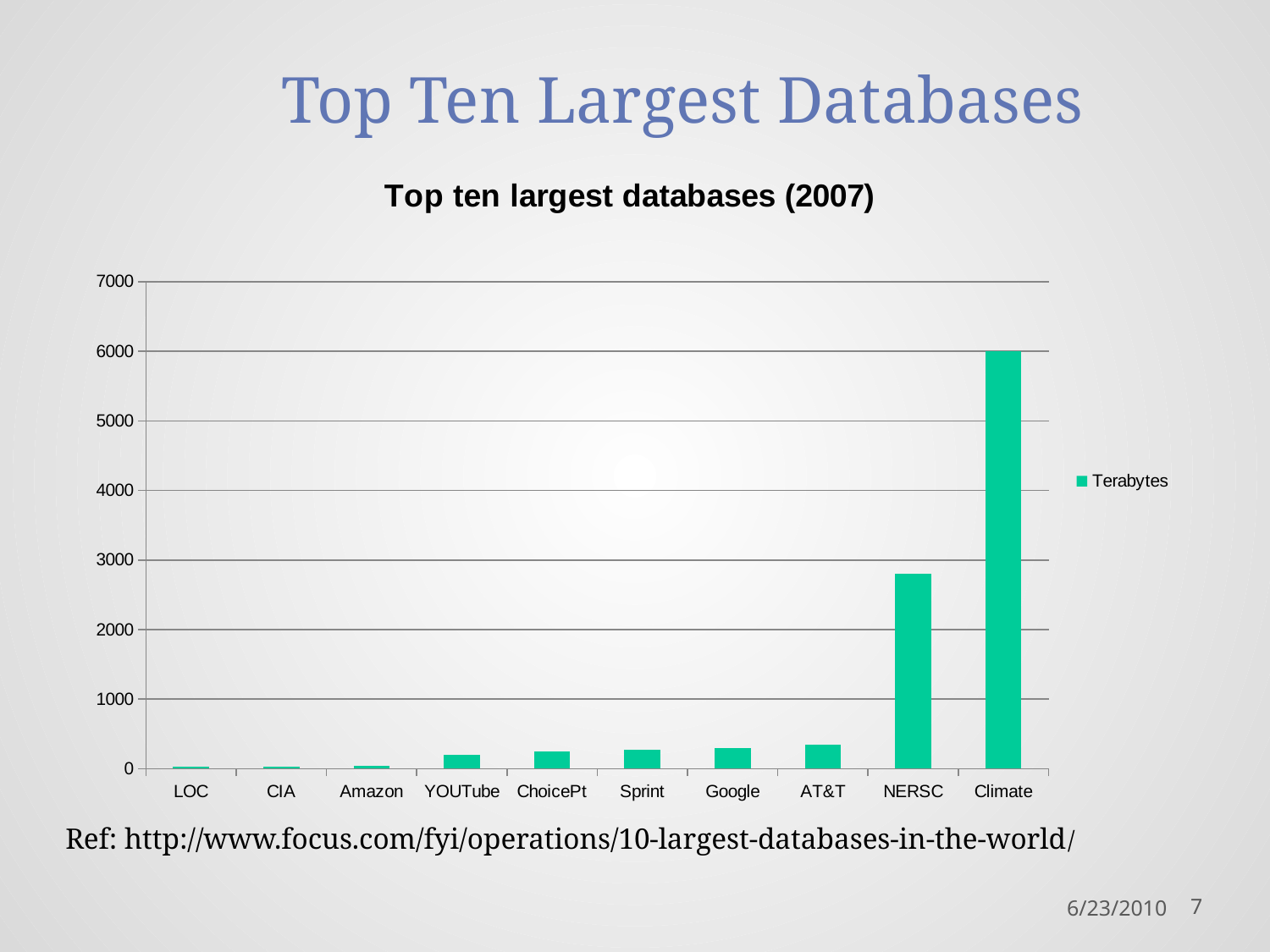
Is the value for Google greater or less than 1000? less What kind of chart is shown on the slide? bar chart What is the value for Climate in terabytes? 6000 How many series does the legend list? 1 How many categories are shown on the x axis of the chart? 10 What is the name of the series shown in the legend? Terabytes Do the values generally rise or fall moving from left to right along the x axis? rise Is the value for NERSC greater or less than 3000? less Which is larger, the value for NERSC or the value for AT&T? NERSC Which category has the highest value? Climate What is the title of the chart? Top ten largest databases (2007) Is the value for NERSC greater or less than 2000? greater